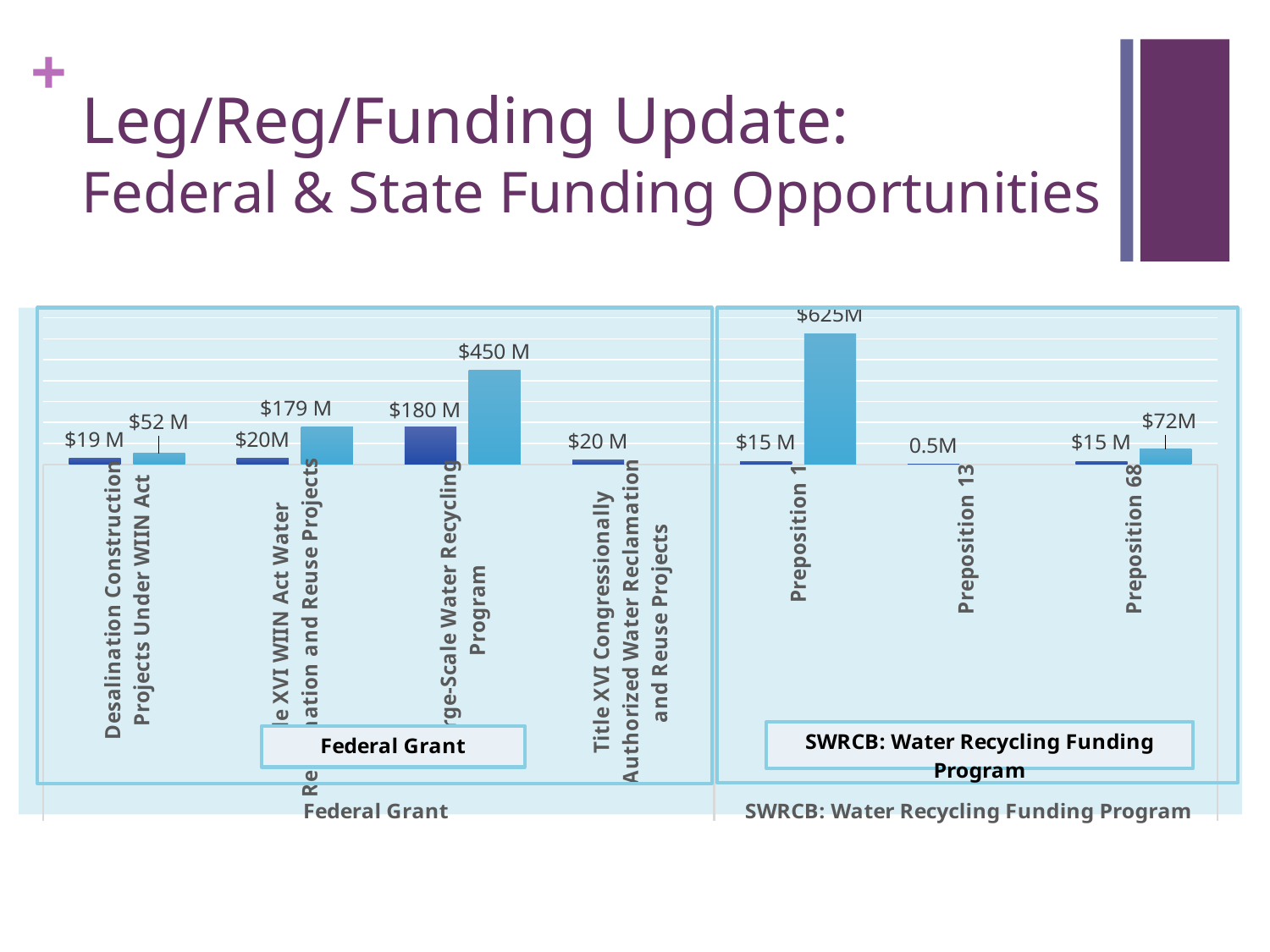
What is the value of the tallest bar for Desalination Construction Projects Under WIIN Act? $52 M What is the value labelled for Title XVI Congressionally Authorized Water Reclamation and Reuse Projects? $20 M Which is larger: the light blue bar for Large-Scale Water Recycling Program or the light blue bar for Preposition 68? Large-Scale Water Recycling Program What is the value of the tallest bar for Preposition 1? $625M What is the value of the light blue bar for Preposition 68? $72M What is the value of the dark blue bar for Large-Scale Water Recycling Program? $180 M What is the value labelled for Preposition 13? 0.5M What is the value of the light blue bar for Large-Scale Water Recycling Program? $450 M Which category has the tallest bar in the whole chart? Preposition 1 What is the value of the dark blue bar for Desalination Construction Projects Under WIIN Act? $19 M What are the two group labels shown along the bottom of the chart? Federal Grant; SWRCB: Water Recycling Funding Program What kind of chart is shown on the slide? bar chart